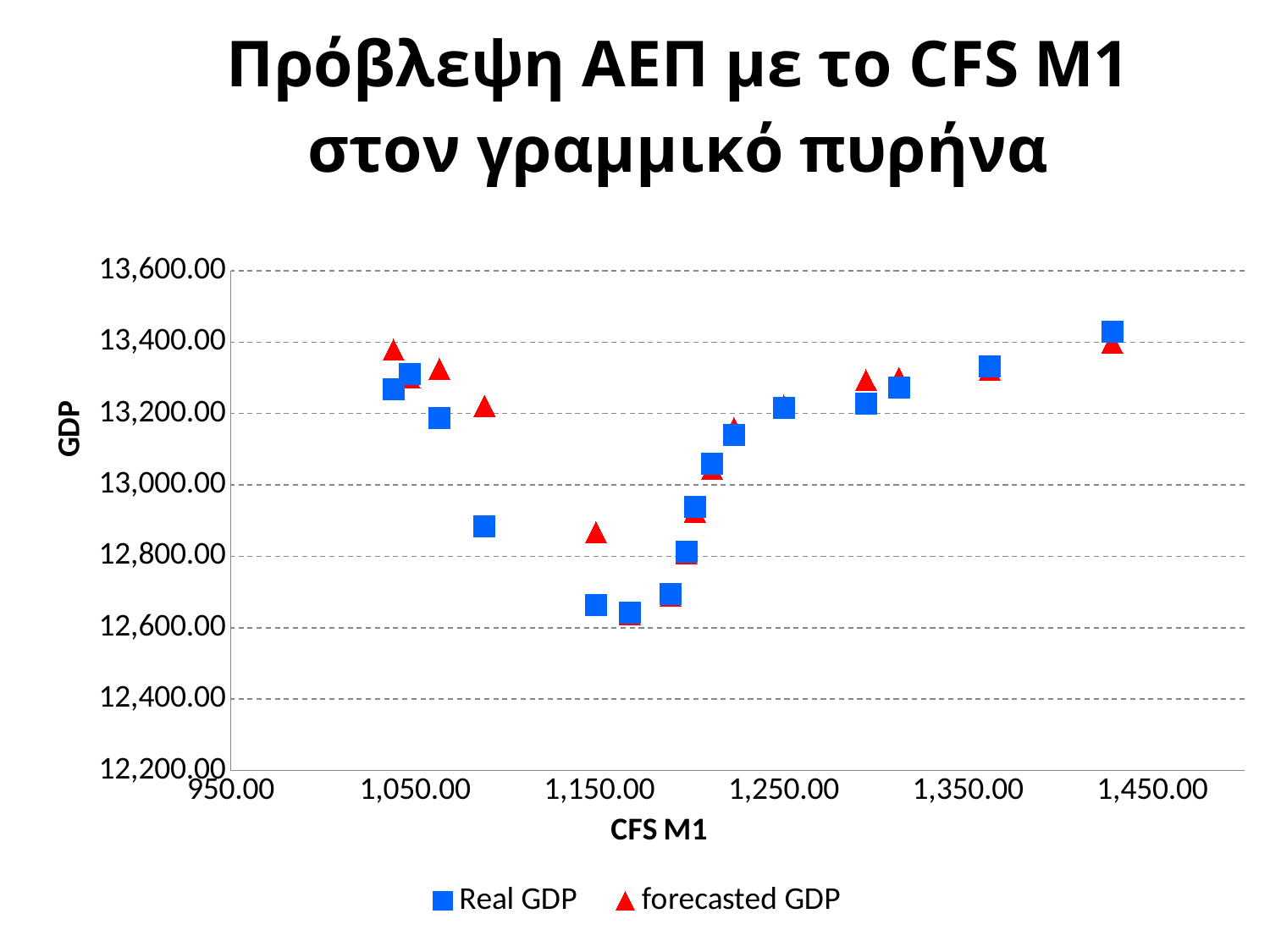
What is the label of the horizontal axis? CFS M1 Is the forecasted GDP value at the leftmost point (CFS M1 around 1,040) greater or less than 13,200.00? greater Do the Real GDP values rise or fall as CFS M1 increases from 1,250.00 to 1,450.00? rise At CFS M1 around 1,085, which is higher: Real GDP or forecasted GDP? forecasted GDP Is the Real GDP value at CFS M1 around 1,085 greater or less than 13,000.00? less What kind of chart is shown on the slide? scatter chart What are the two series named in the legend? Real GDP and forecasted GDP At the leftmost point (CFS M1 around 1,040), which is higher: Real GDP or forecasted GDP? forecasted GDP Is the Real GDP value at the rightmost point (CFS M1 around 1,430) greater or less than 13,200.00? greater How many series does the legend list? 2 Do the Real GDP values rise or fall as CFS M1 increases from 1,050.00 to 1,150.00? fall